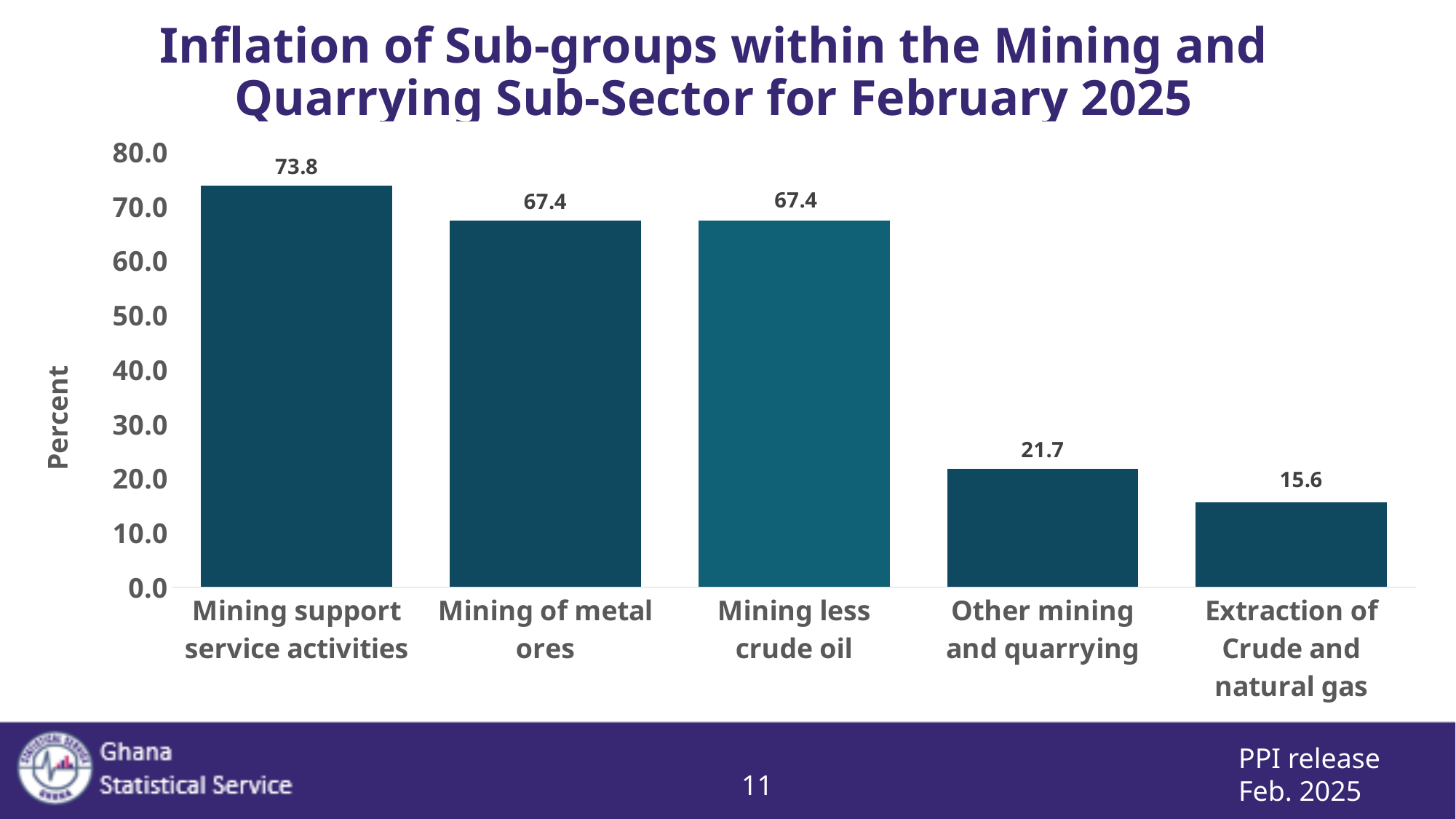
Which is larger, the inflation for Mining less crude oil or for Other mining and quarrying? Mining less crude oil What is the difference between the inflation for Mining support service activities and Mining of metal ores? 6.4 What is the inflation value for Other mining and quarrying? 21.7 Which sub-group has the lowest inflation? Extraction of Crude and natural gas What is the difference between the inflation for Other mining and quarrying and Extraction of Crude and natural gas? 6.1 Which sub-group has the highest inflation? Mining support service activities What is the inflation value for Mining of metal ores? 67.4 What is the inflation value for Extraction of Crude and natural gas? 15.6 How many sub-groups are shown in the chart? 5 What is the inflation value for Mining support service activities? 73.8 What is the label of the vertical axis? Percent What kind of chart is shown on the slide? Bar chart